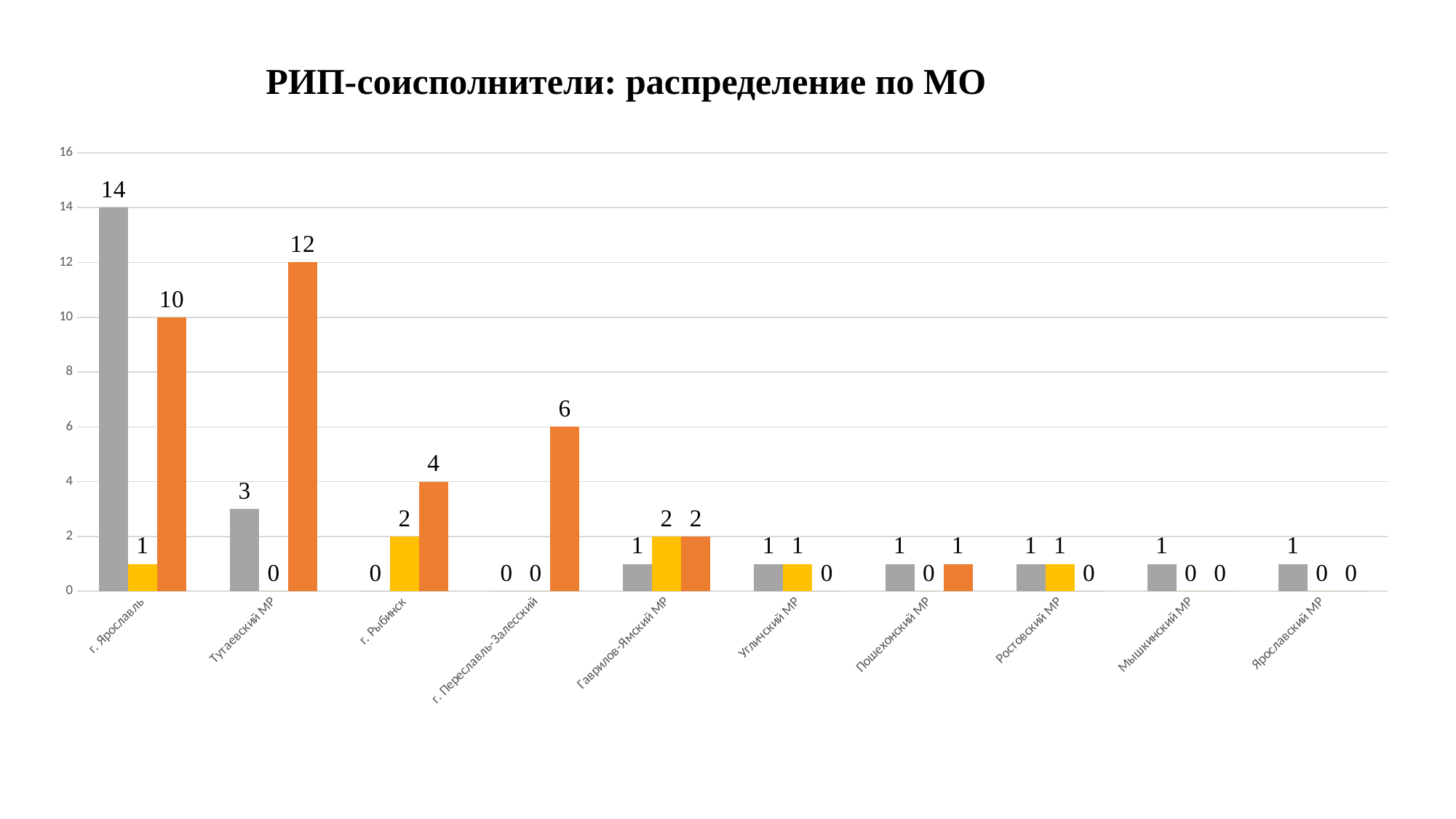
What is the value of the grey bar for г. Ярославль? 14 What is the value of the yellow bar for г. Рыбинск? 2 What is the difference between the grey bar and the orange bar for г. Ярославль? 4 What is the title of the chart? РИП-соисполнители: распределение по МО What kind of chart is shown on the slide? bar chart How many categories are shown on the x axis? 10 What is the total of the three bars for Гаврилов-Ямский МР? 5 Which category has the highest orange bar? Тутаевский МР What is the value of the orange bar for Тутаевский МР? 12 Which category has the highest grey bar? г. Ярославль What is the value of the orange bar for г. Переславль-Залесский? 6 Which is larger for Тутаевский МР: the grey bar or the orange bar? the orange bar